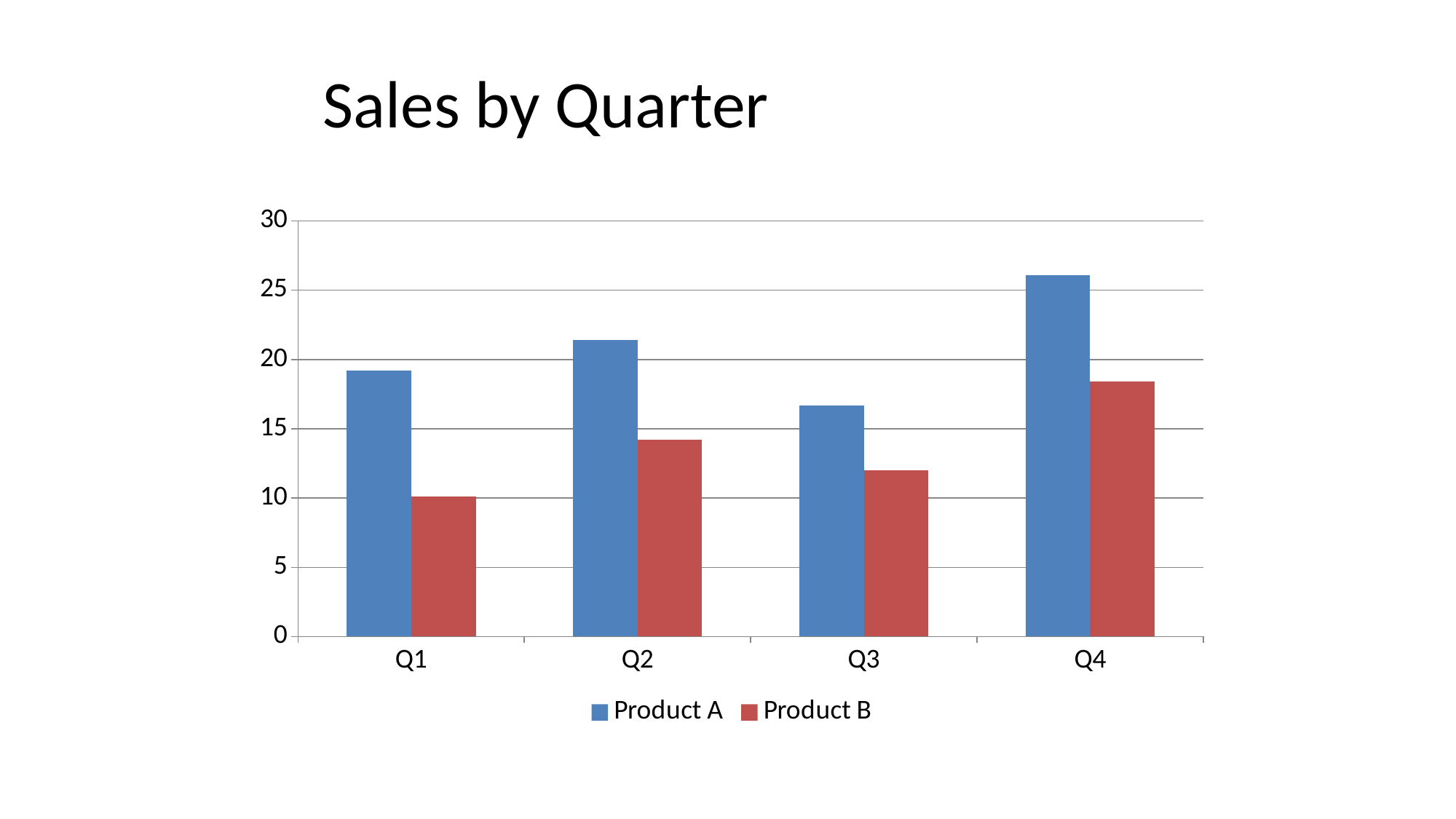
In which quarter is Product A highest? Q4 In which quarter is Product B lowest? Q1 What is the title of the chart? Sales by Quarter Does Product B rise or fall from Q1 to Q2? rise Is the value for Product A in Q3 greater or less than 15? greater How many series does the legend list? 2 In Q1, which is larger, Product A or Product B? Product A Is the value for Product B in Q2 greater or less than 15? less Is the value for Product A in Q4 greater or less than 25? greater In which quarter is Product A lowest? Q3 What kind of chart is shown on the slide? bar chart How many quarters are shown on the x axis? 4